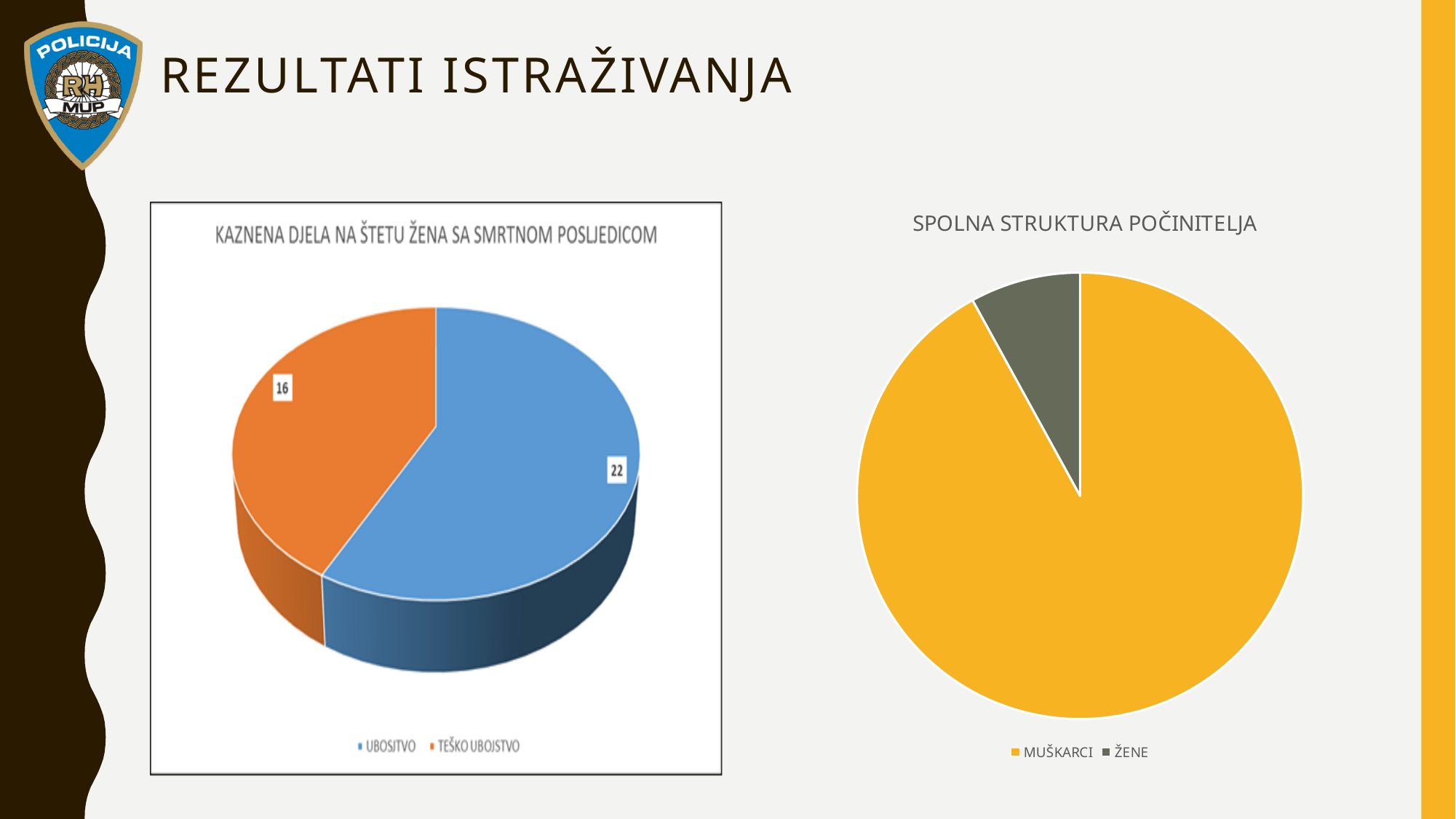
In the chart titled "SPOLNA STRUKTURA POČINITELJA", what colour is the slice for ŽENE? Grey In the chart titled "KAZNENA DJELA NA ŠTETU ŽENA SA SMRTNOM POSLJEDICOM", what is the total of the two slices? 38 In the chart titled "KAZNENA DJELA NA ŠTETU ŽENA SA SMRTNOM POSLJEDICOM", which category has the larger value? UBOJSTVO In the chart titled "KAZNENA DJELA NA ŠTETU ŽENA SA SMRTNOM POSLJEDICOM", what is the difference between the values for UBOJSTVO and TEŠKO UBOJSTVO? 6 In the chart titled "KAZNENA DJELA NA ŠTETU ŽENA SA SMRTNOM POSLJEDICOM", what is the value for TEŠKO UBOJSTVO? 16 In the chart titled "KAZNENA DJELA NA ŠTETU ŽENA SA SMRTNOM POSLJEDICOM", how many categories are shown? 2 In the chart titled "SPOLNA STRUKTURA POČINITELJA", which category has the larger slice? MUŠKARCI How many entries does the legend of the chart titled "SPOLNA STRUKTURA POČINITELJA" list? 2 In the chart titled "SPOLNA STRUKTURA POČINITELJA", which category has the smaller slice? ŽENE In the chart titled "KAZNENA DJELA NA ŠTETU ŽENA SA SMRTNOM POSLJEDICOM", which category has the smaller value? TEŠKO UBOJSTVO In the chart titled "KAZNENA DJELA NA ŠTETU ŽENA SA SMRTNOM POSLJEDICOM", what is the value for UBOJSTVO? 22 What kind of chart is the chart titled "KAZNENA DJELA NA ŠTETU ŽENA SA SMRTNOM POSLJEDICOM"? Pie chart